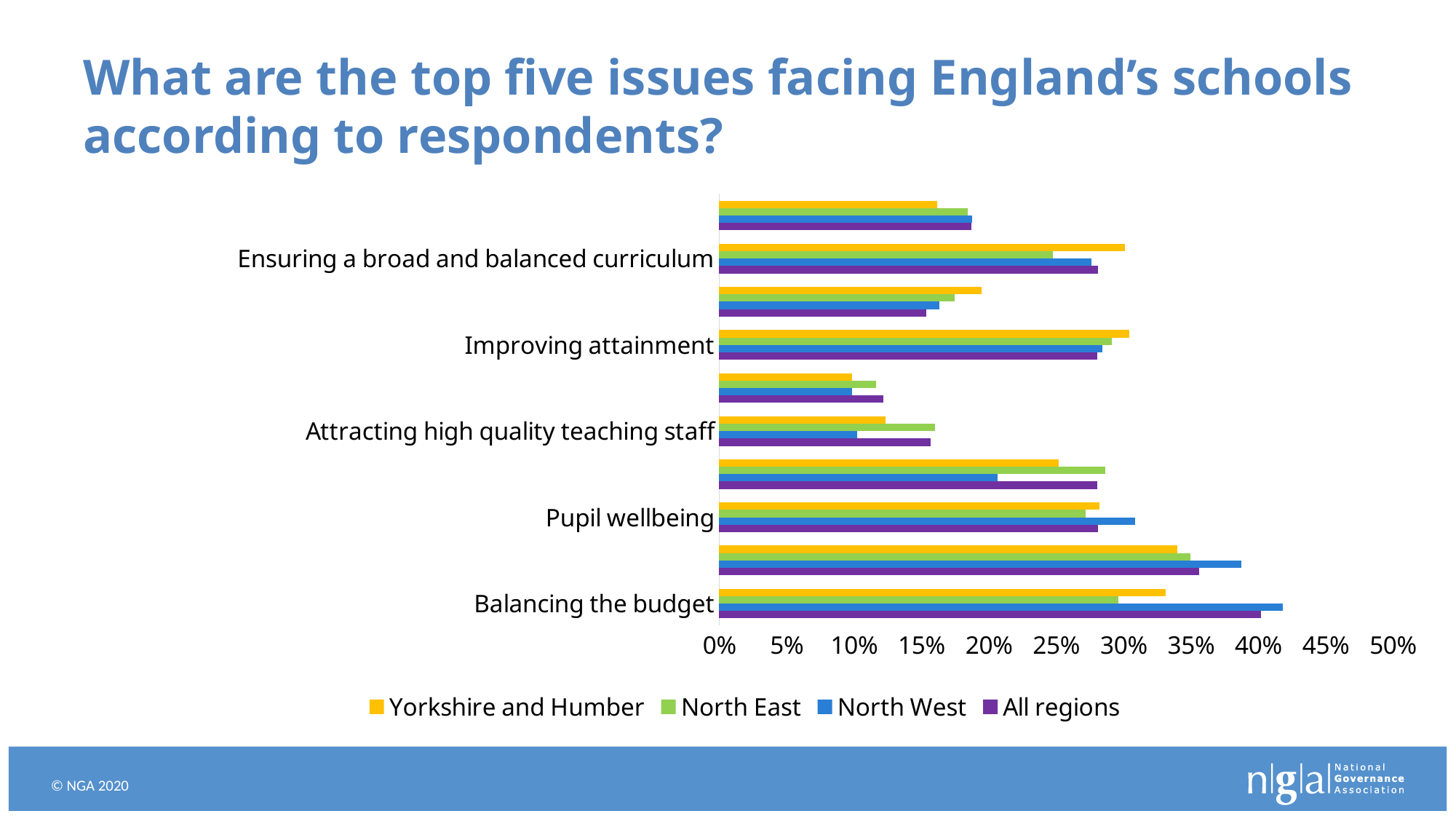
How many series does the legend list? 4 Is the Yorkshire and Humber value for Attracting high quality teaching staff greater or less than 10%? greater Which colour represents North West in the legend? blue Is the North West value for Balancing the budget greater or less than 40%? greater Is the North East value for Ensuring a broad and balanced curriculum greater or less than 30%? less For Ensuring a broad and balanced curriculum, which is larger: the Yorkshire and Humber value or the North East value? Yorkshire and Humber For Attracting high quality teaching staff, which is larger: the North East value or the North West value? North East What kind of chart is shown on the slide? bar chart For Balancing the budget, which region has the highest value? North West Which category has the longest bar on the chart? Balancing the budget